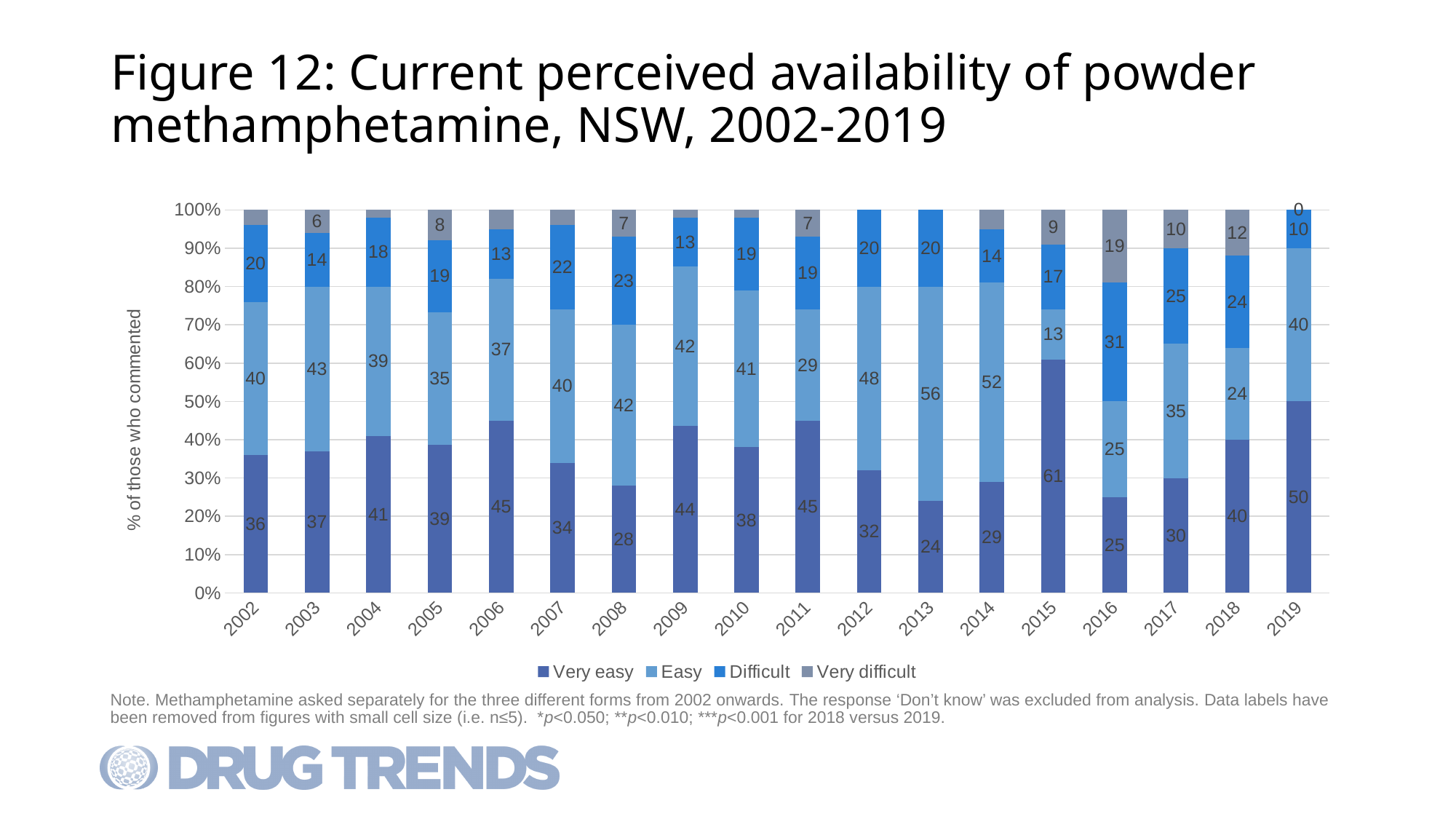
How many years are shown on the x axis? 18 What is the 'Very difficult' value for 2018? 12 What is the 'Difficult' value for 2016? 31 What kind of chart is shown on the slide? Stacked bar chart What is the 'Easy' value for 2013? 56 How many series does the legend list? 4 Which is larger, the 'Easy' value for 2012 or the 'Easy' value for 2016? 2012 What is the difference between the 'Very easy' values for 2019 and 2018? 10 What is the label on the vertical axis? % of those who commented In which year is the 'Very easy' segment the smallest? 2013 What percentage of respondents rated powder methamphetamine as 'Very easy' to obtain in 2015? 61 In which year is the 'Very easy' segment the largest? 2015